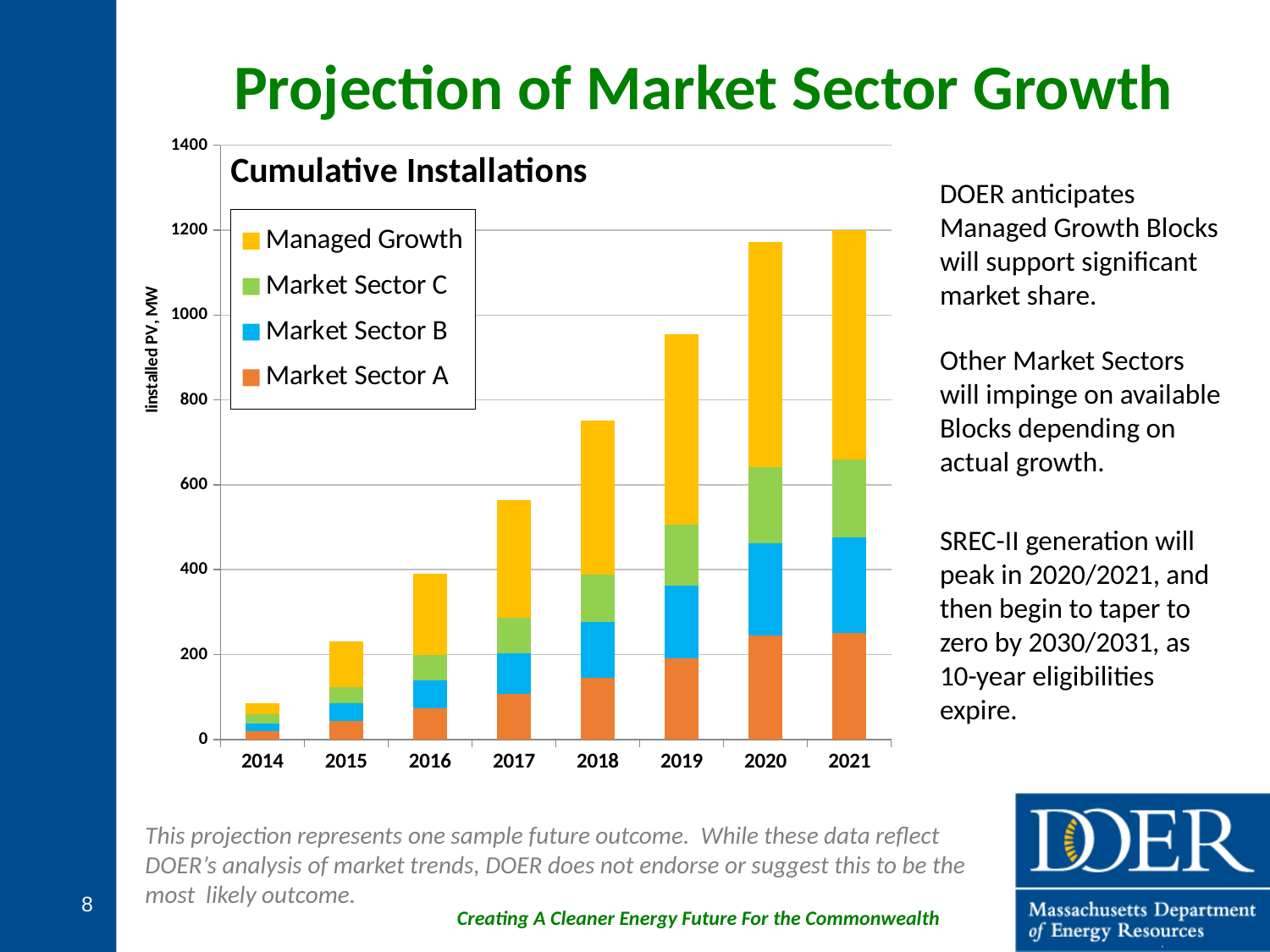
Is the total bar for 2020 greater or less than 1000? greater Is the total bar for 2018 greater or less than 600? greater How many years are shown on the x axis of the chart? 8 Is the total bar for 2015 greater or less than 400? less Which year has the lowest total cumulative installations? 2014 What is the title shown inside the chart area? Cumulative Installations What kind of chart is shown on the slide? Stacked bar chart How many series does the chart's legend list? 4 Which year has a taller total bar, 2018 or 2019? 2019 Do total cumulative installations rise or fall from 2014 to 2021? Rise Which year has the highest total cumulative installations? 2021 Which series is shown at the top of each stacked bar? Managed Growth